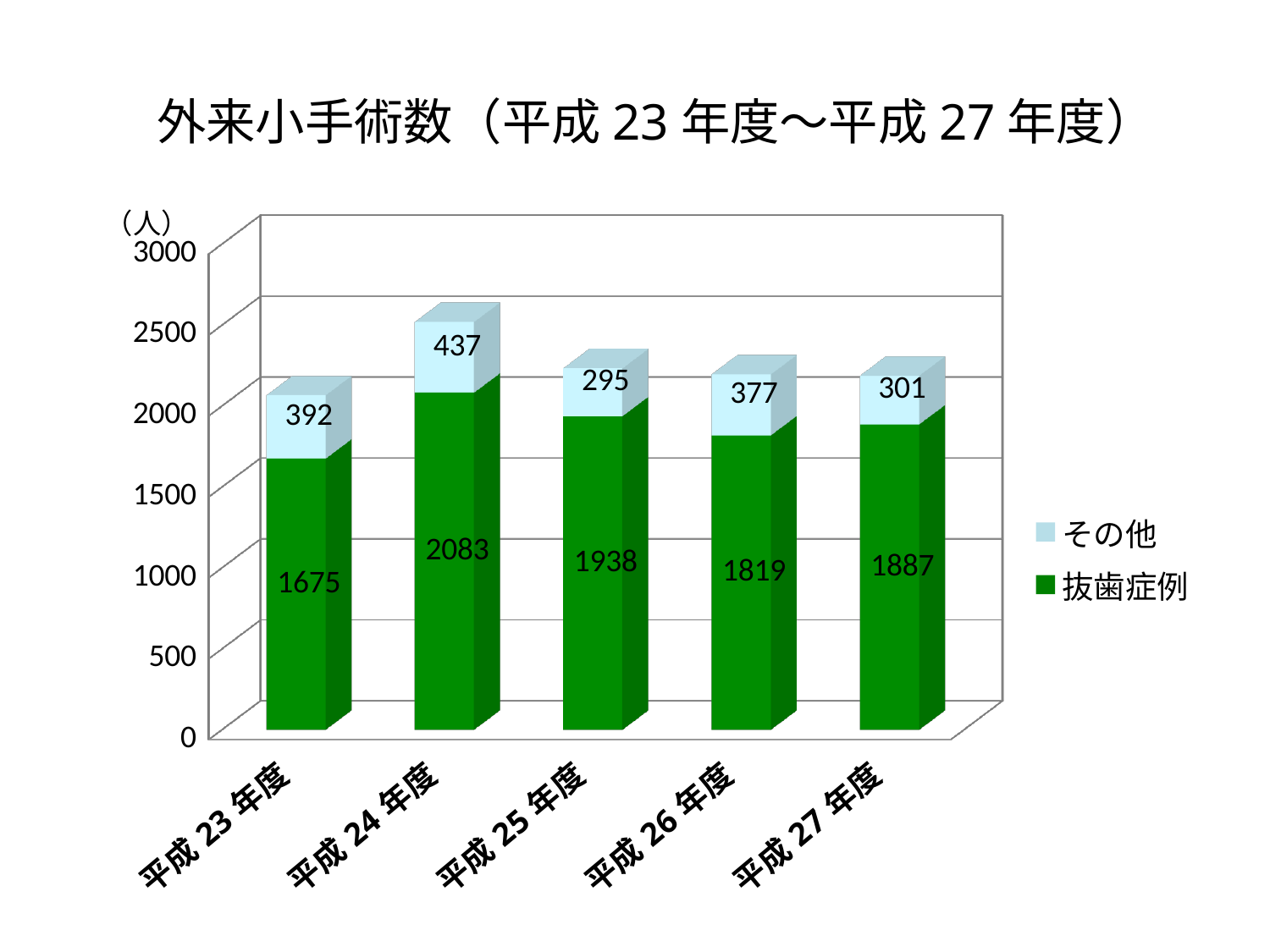
What is the difference between the 抜歯症例 values for 平成24年度 and 平成23年度? 408 What is the value of 抜歯症例 for 平成24年度? 2083 What kind of chart is shown on the slide? Stacked bar chart How many series does the legend list? 2 What is the total of the stacked bar for 平成23年度? 2067 What is the total of the stacked bar for 平成24年度? 2520 How many years are shown on the x axis? 5 Which year has the lowest value for その他? 平成25年度 What is the value of 抜歯症例 for 平成27年度? 1887 Which is larger, the その他 value for 平成23年度 or for 平成27年度? 平成23年度 Which year has the highest value for 抜歯症例? 平成24年度 What is the value of その他 for 平成26年度? 377